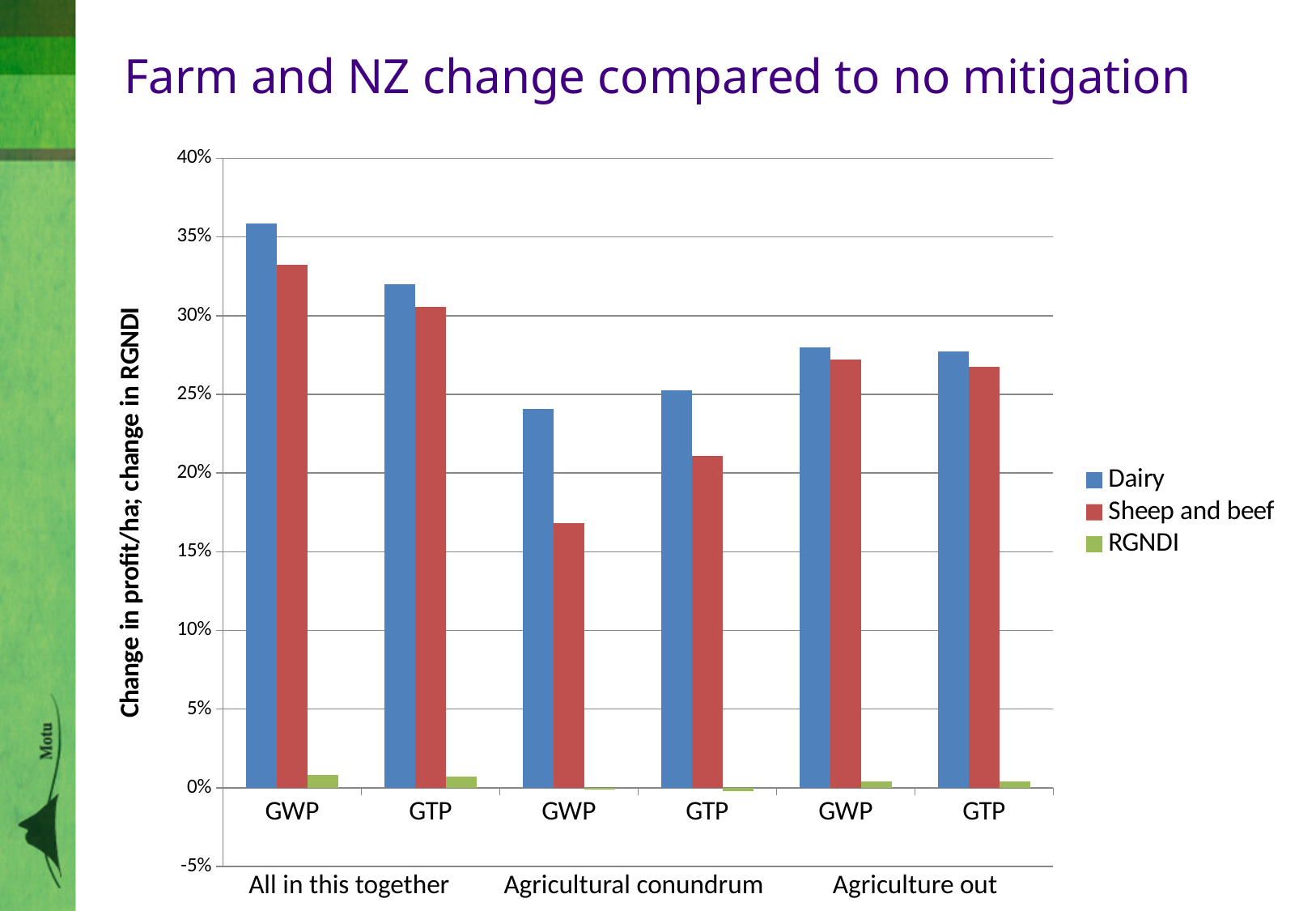
What are the three series listed in the legend? Dairy, Sheep and beef, RGNDI For Agricultural conundrum GWP, which is larger: Dairy or Sheep and beef? Dairy Is the RGNDI value for All in this together GWP greater or less than 5%? less Which category has the lowest Sheep and beef value? Agricultural conundrum, GWP Is the Sheep and beef value for Agricultural conundrum GWP greater or less than 20%? less Is the Dairy value for All in this together GWP greater or less than 30%? greater How many series does the legend list? 3 What kind of chart is shown on the slide? bar chart For Dairy under All in this together, which is larger: GWP or GTP? GWP Which category has the highest Dairy value? All in this together, GWP How many category groups (GWP/GTP bars) are shown along the x axis? 6